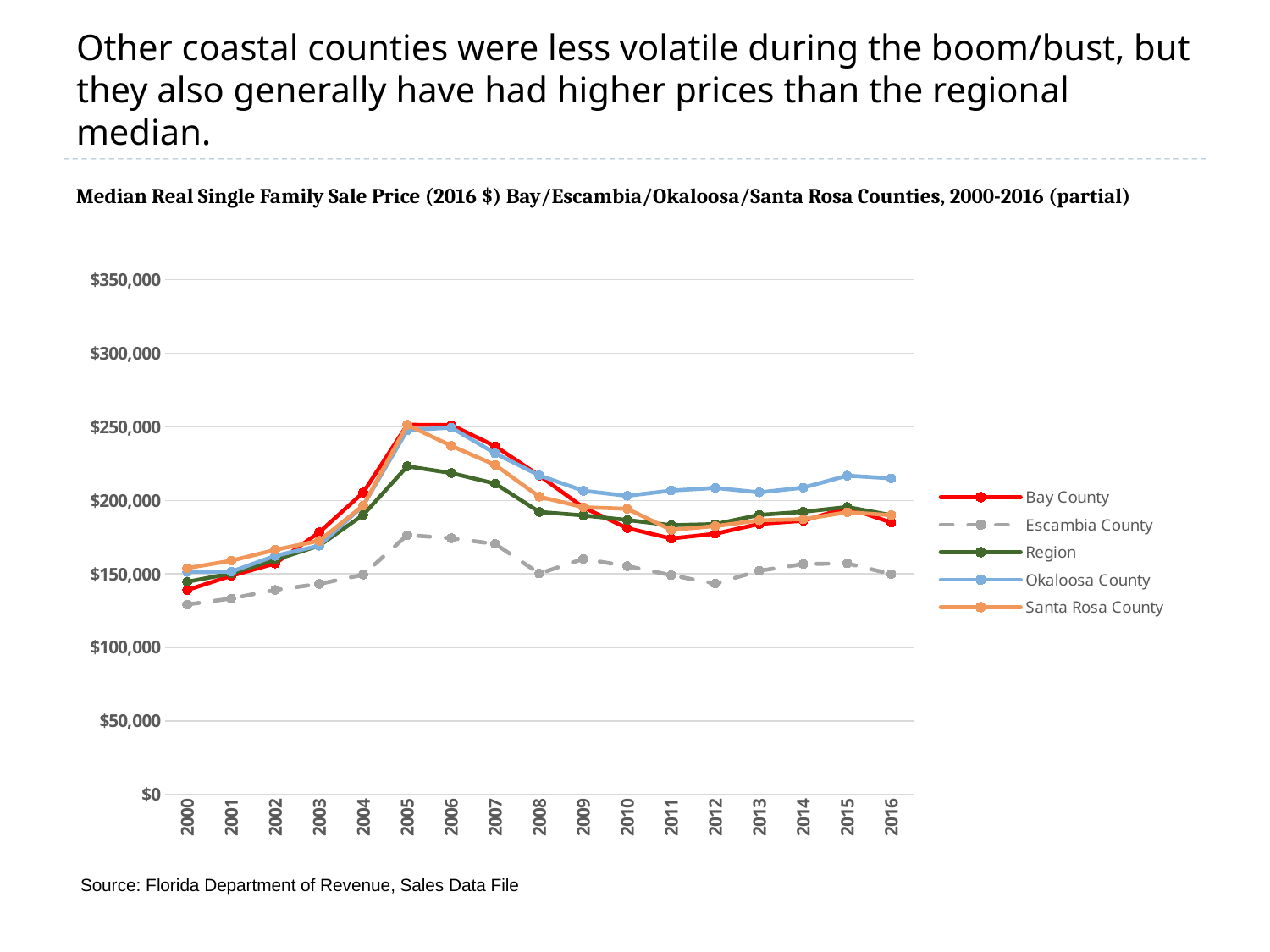
What kind of chart is shown on the slide? line chart Is the value for Region in 2005 greater or less than $200,000? greater In 2016, which is larger: Okaloosa County or Bay County? Okaloosa County How many years are plotted along the x axis? 17 In which year is the Santa Rosa County value highest? 2005 Is the value for Bay County in 2016 greater or less than $200,000? less Is the value for Okaloosa County in 2016 greater or less than $200,000? greater Does the Bay County line rise or fall from 2005 to 2011? fall Which series is drawn with a dashed line? Escambia County In which year is the Escambia County value lowest? 2000 How many series does the legend list? 5